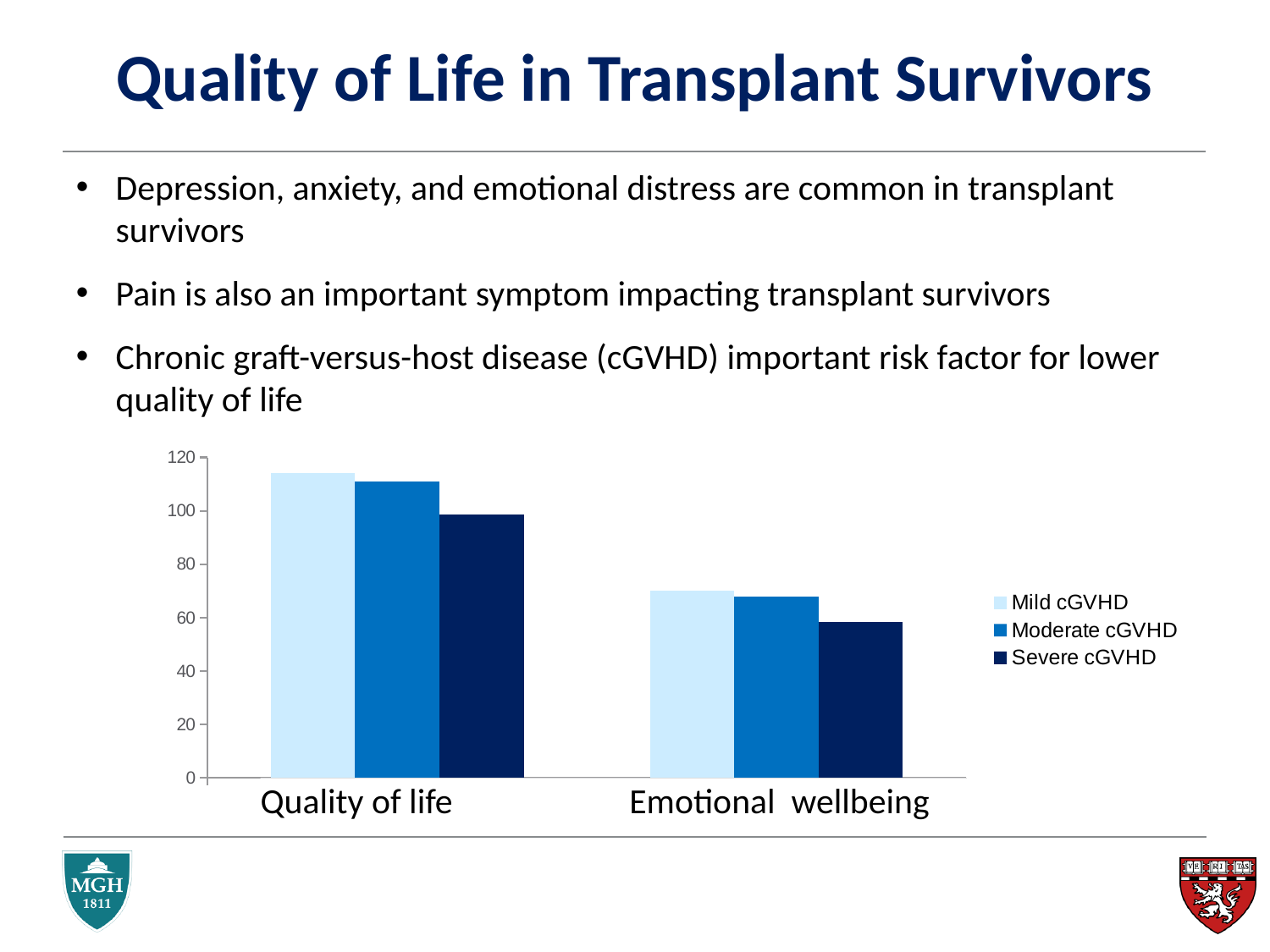
Which legend entry is shown in the darkest blue? Severe cGVHD Which series has the lowest value for Emotional wellbeing? Severe cGVHD Is the Mild cGVHD value for Emotional wellbeing greater or less than 60? greater Is the Mild cGVHD value for Quality of life greater or less than 100? greater Which is larger: the Mild cGVHD value for Quality of life or the Mild cGVHD value for Emotional wellbeing? Quality of life What kind of chart is shown on the slide? bar chart How many series does the chart legend list? 3 Which series has the lowest value for Quality of life? Severe cGVHD How many categories are shown on the x axis of the chart? 2 Within each category, do the values rise or fall going from Mild cGVHD to Severe cGVHD? fall